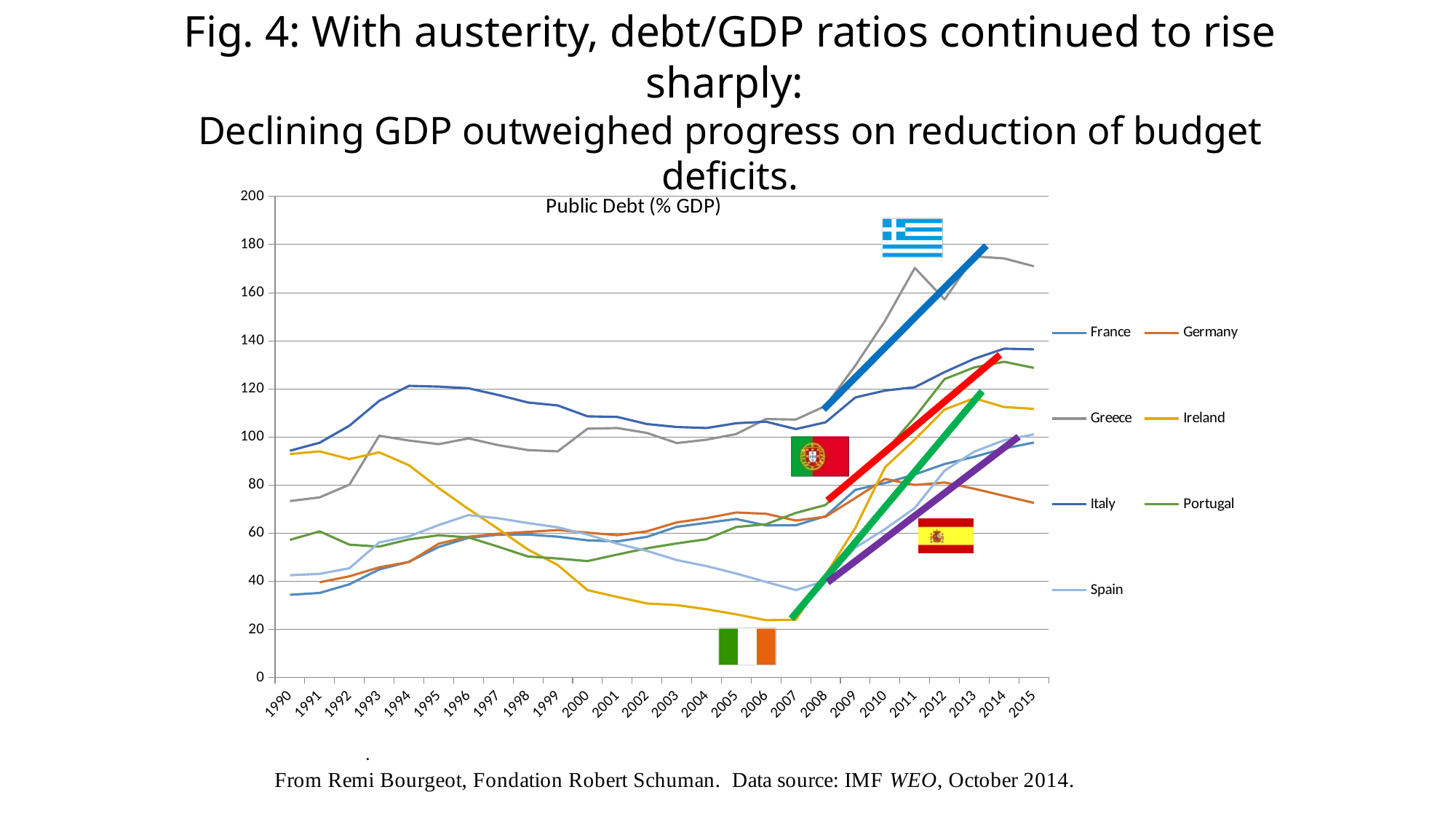
What kind of chart is shown on the slide? line chart How many years are shown along the x axis of the chart? 26 In 2015, which is larger: the value for Italy or the value for Germany? Italy Is the value for Germany in 2015 greater or less than 80? less What is the title of the chart? Public Debt (% GDP) Is the value for Ireland in 2007 greater or less than 40? less Which country has the lowest public debt (% GDP) in 2007? Ireland How many series does the legend of the Public Debt (% GDP) chart list? 7 Is the value for Greece in 2011 greater or less than 140? greater Does the value for Greece rise or fall between 2008 and 2011? rise Does the value for Ireland rise or fall between 1993 and 2007? fall Which country has the highest public debt (% GDP) in 2015? Greece